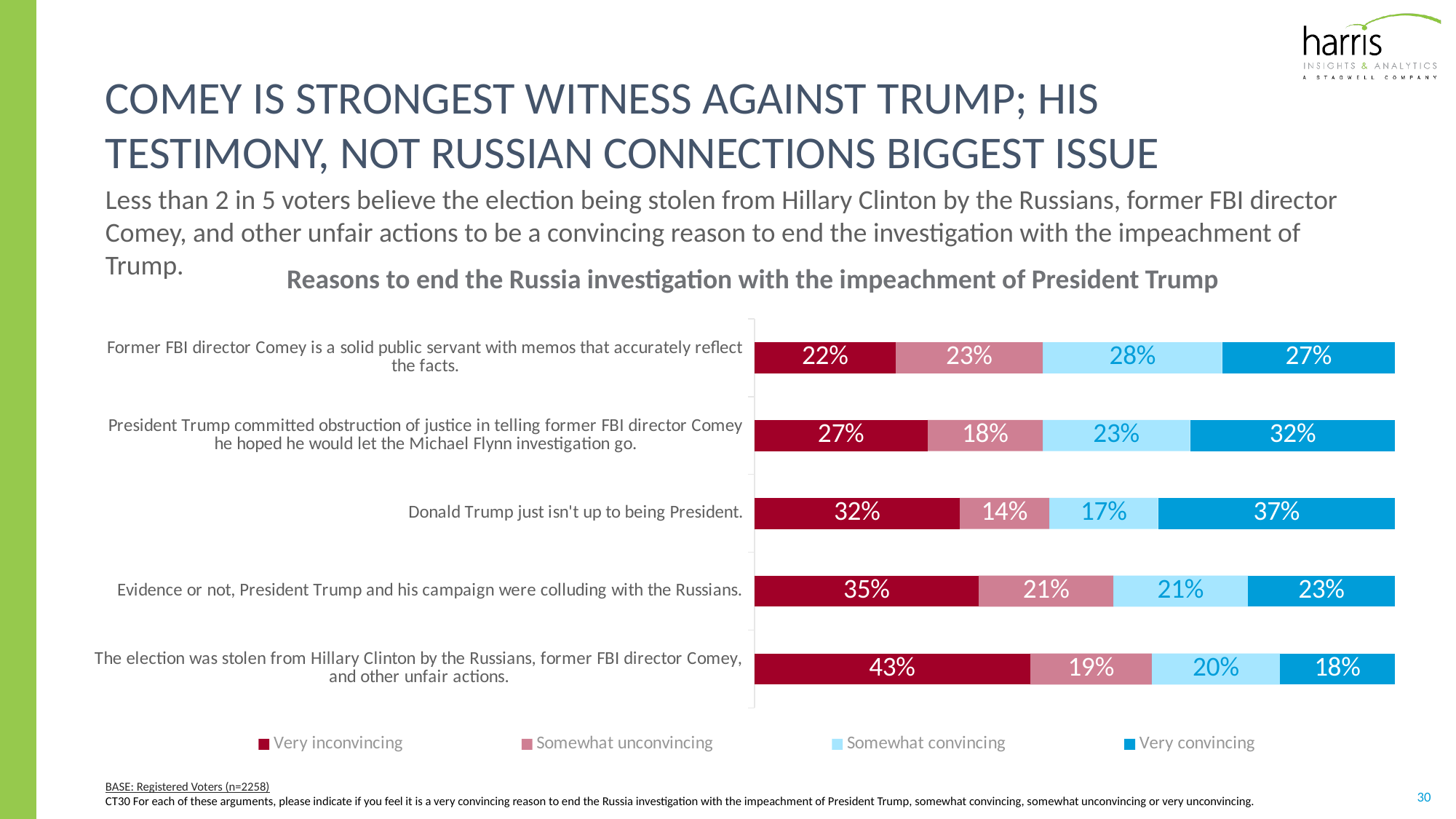
What is the total of the four segments for the statement "Former FBI director Comey is a solid public servant with memos that accurately reflect the facts."? 100% What percentage of voters find "The election was stolen from Hillary Clinton by the Russians, former FBI director Comey, and other unfair actions." very inconvincing? 43% For the statement "Former FBI director Comey is a solid public servant with memos that accurately reflect the facts.", what is the difference between the "Very convincing" and "Very inconvincing" percentages? 5 percentage points Which statement has the highest "Very inconvincing" percentage? The election was stolen from Hillary Clinton by the Russians, former FBI director Comey, and other unfair actions. Which has a higher "Somewhat convincing" percentage: the Comey solid public servant statement or the obstruction of justice statement? The Comey solid public servant statement Which statement has the lowest "Very convincing" percentage? The election was stolen from Hillary Clinton by the Russians, former FBI director Comey, and other unfair actions. What type of chart is shown on the slide? Stacked bar chart What is the title of the chart? Reasons to end the Russia investigation with the impeachment of President Trump How many statements are shown in the chart? 5 How many response categories does the legend list? 4 Which statement has the lowest "Somewhat unconvincing" percentage? Donald Trump just isn't up to being President. What percentage of voters find "Donald Trump just isn't up to being President." very convincing? 37%